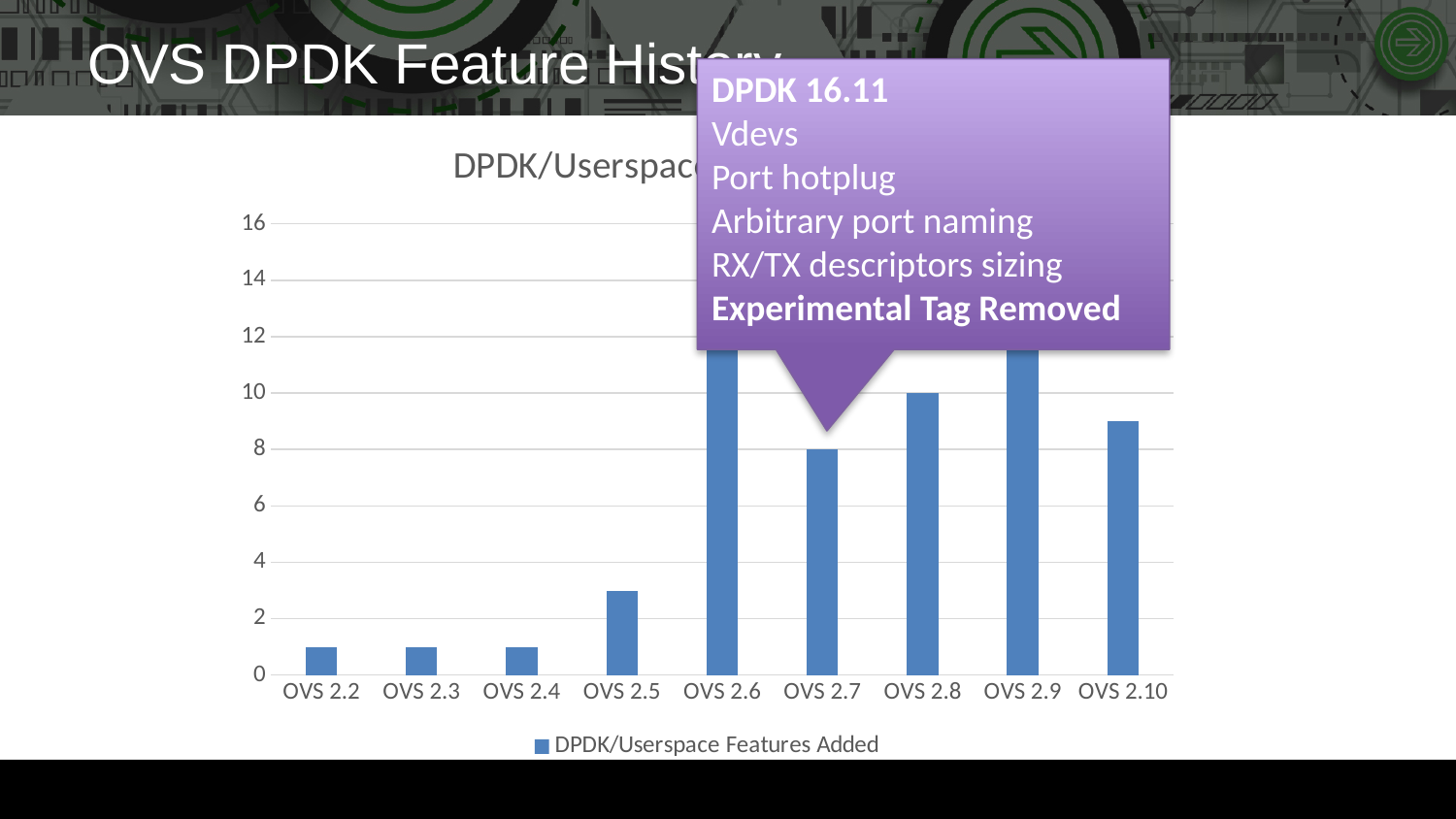
Which has a larger value, OVS 2.5 or OVS 2.4? OVS 2.5 Is the value for OVS 2.10 greater or less than 10? less What is the value for OVS 2.7? 8 How many OVS versions are shown on the x axis of the chart? 9 What type of chart is shown on the slide? bar chart What series name is shown in the chart legend? DPDK/Userspace Features Added Is the value for OVS 2.2 greater or less than 2? less What is the value for OVS 2.8? 10 Is the value for OVS 2.6 greater or less than 10? greater What is the difference between the values for OVS 2.8 and OVS 2.7? 2 How many series does the chart legend list? 1 Which has a larger value, OVS 2.8 or OVS 2.7? OVS 2.8